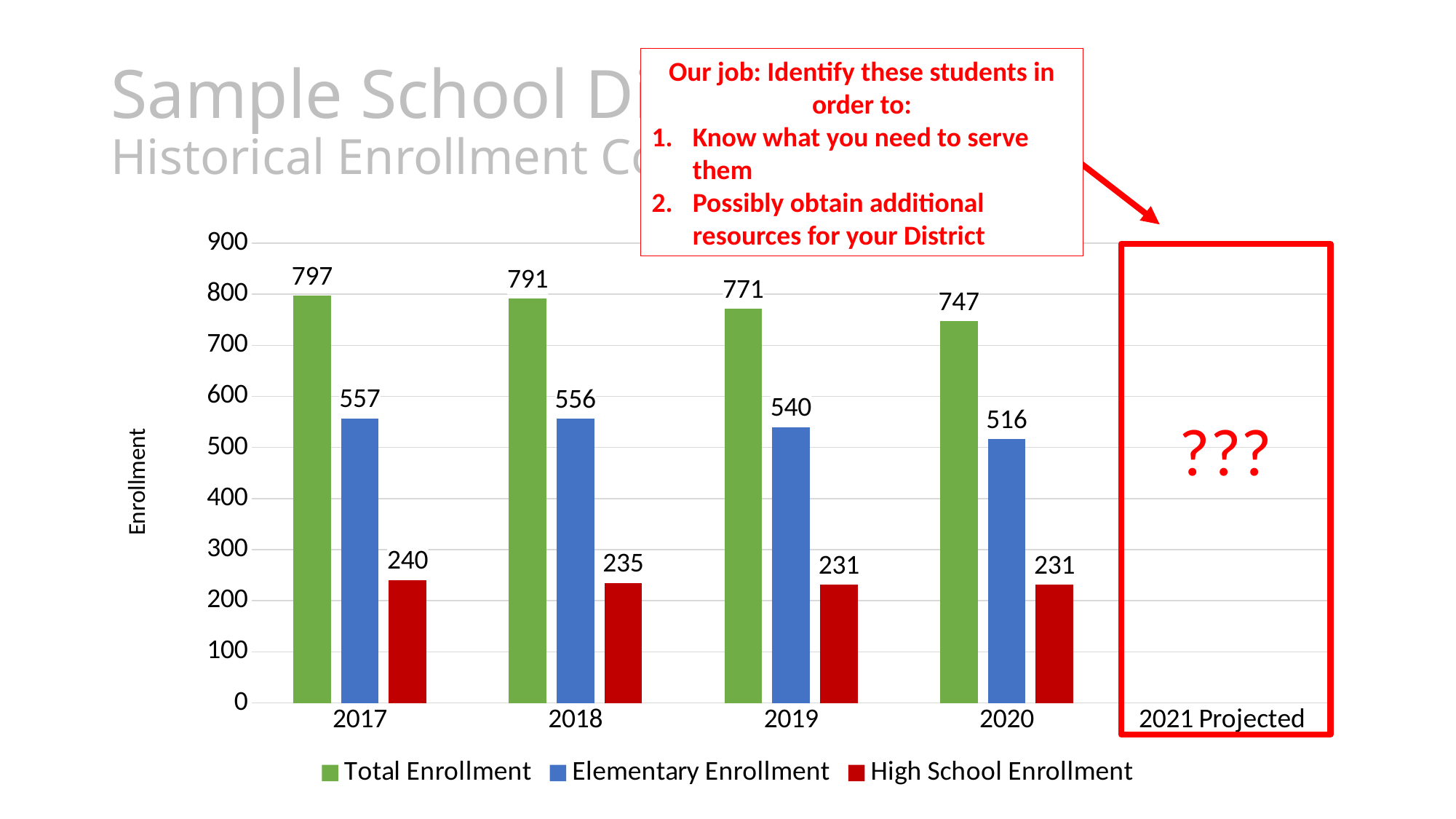
Which is larger: Elementary Enrollment in 2017 or Elementary Enrollment in 2020? Elementary Enrollment in 2017 What was the Elementary Enrollment in 2019? 540 What is the difference between Elementary Enrollment and High School Enrollment in 2018? 321 Which year had the lowest Elementary Enrollment? 2020 What is the difference between Total Enrollment in 2017 and in 2020? 50 What is the label of the y axis? Enrollment What was the Total Enrollment in 2017? 797 What kind of chart is shown on the slide? Bar chart What was the High School Enrollment in 2020? 231 Which year had the highest Total Enrollment? 2017 How many series does the legend list? 3 Does Total Enrollment rise or fall from 2017 to 2020? Fall